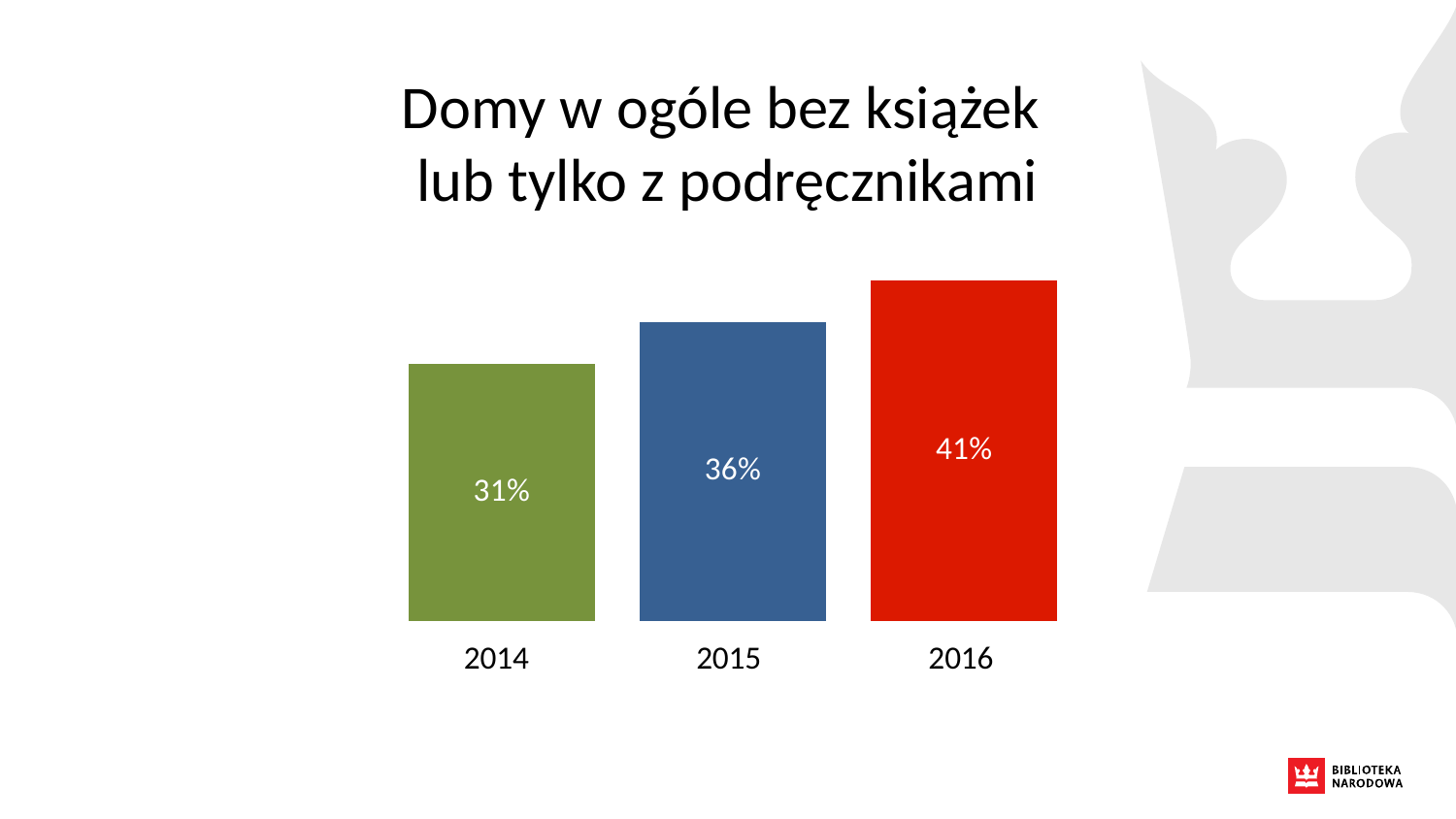
Which is larger, the value for 2015 or the value for 2016? 2016 What is the value for 2015? 36% Do the values rise or fall from 2014 to 2016? rise What is the value for 2016? 41% What kind of chart is shown on the slide? bar chart Which year has the lowest value? 2014 What is the difference between the values for 2015 and 2014? 5% What is the value for 2014? 31% What is the difference between the values for 2016 and 2014? 10% What is the title of the chart? Domy w ogóle bez książek lub tylko z podręcznikami Which year has the highest value? 2016 How many years are shown in the chart? 3